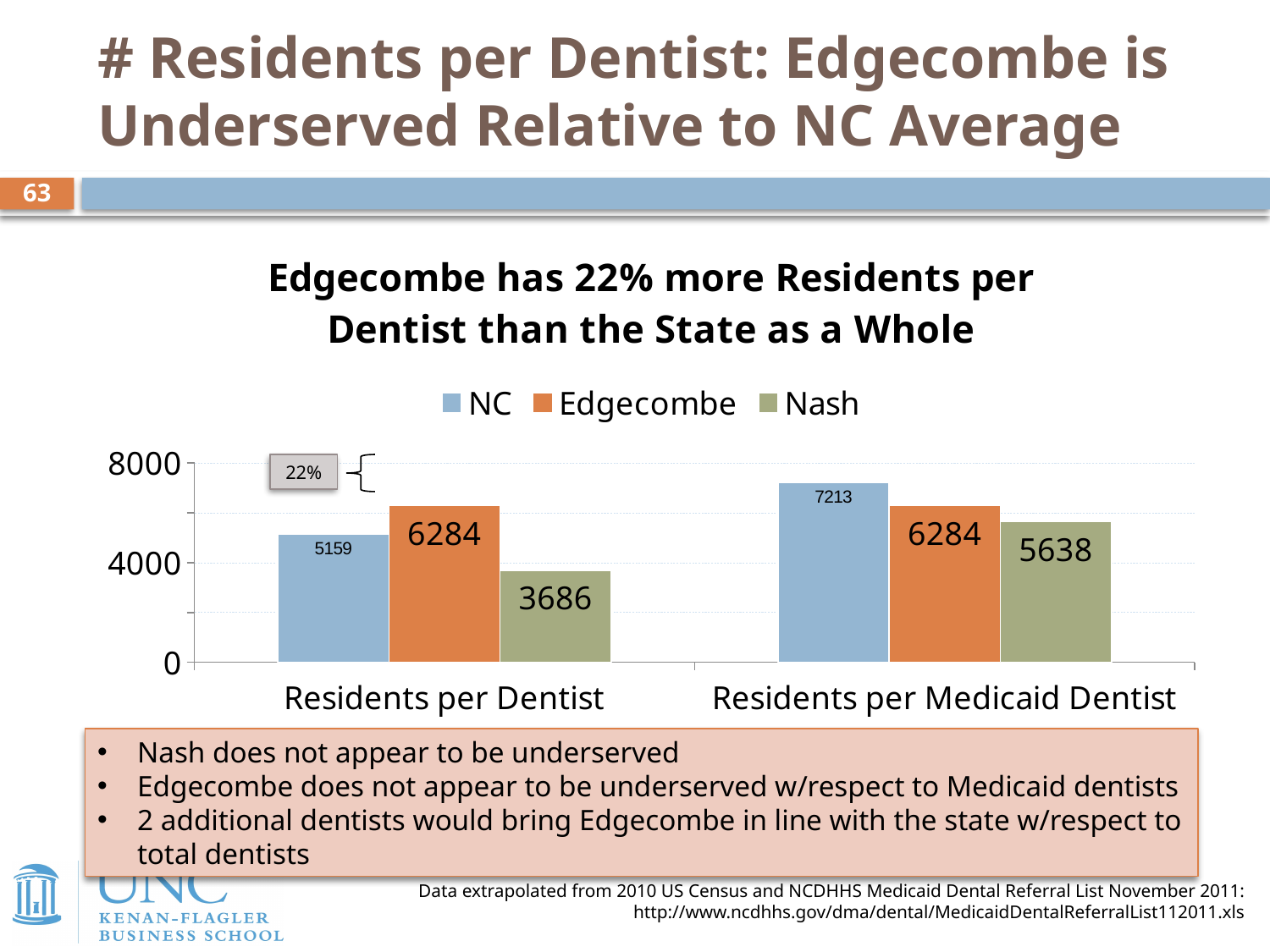
Which is larger in the Residents per Medicaid Dentist category, NC or Nash? NC Is the value for Nash in the Residents per Dentist category greater or less than 4000? less What kind of chart is shown on the slide? bar chart What is the difference between the Edgecombe and NC values in the Residents per Dentist category? 1125 What is the value for Edgecombe in the Residents per Medicaid Dentist category? 6284 Which series has the highest value in the Residents per Dentist category? Edgecombe What is the title of the chart? Edgecombe has 22% more Residents per Dentist than the State as a Whole What is the value for NC in the Residents per Dentist category? 5159 Which series has the lowest value in the Residents per Medicaid Dentist category? Nash What is the value for Nash in the Residents per Dentist category? 3686 How many series does the legend list? 3 What is the value for NC in the Residents per Medicaid Dentist category? 7213